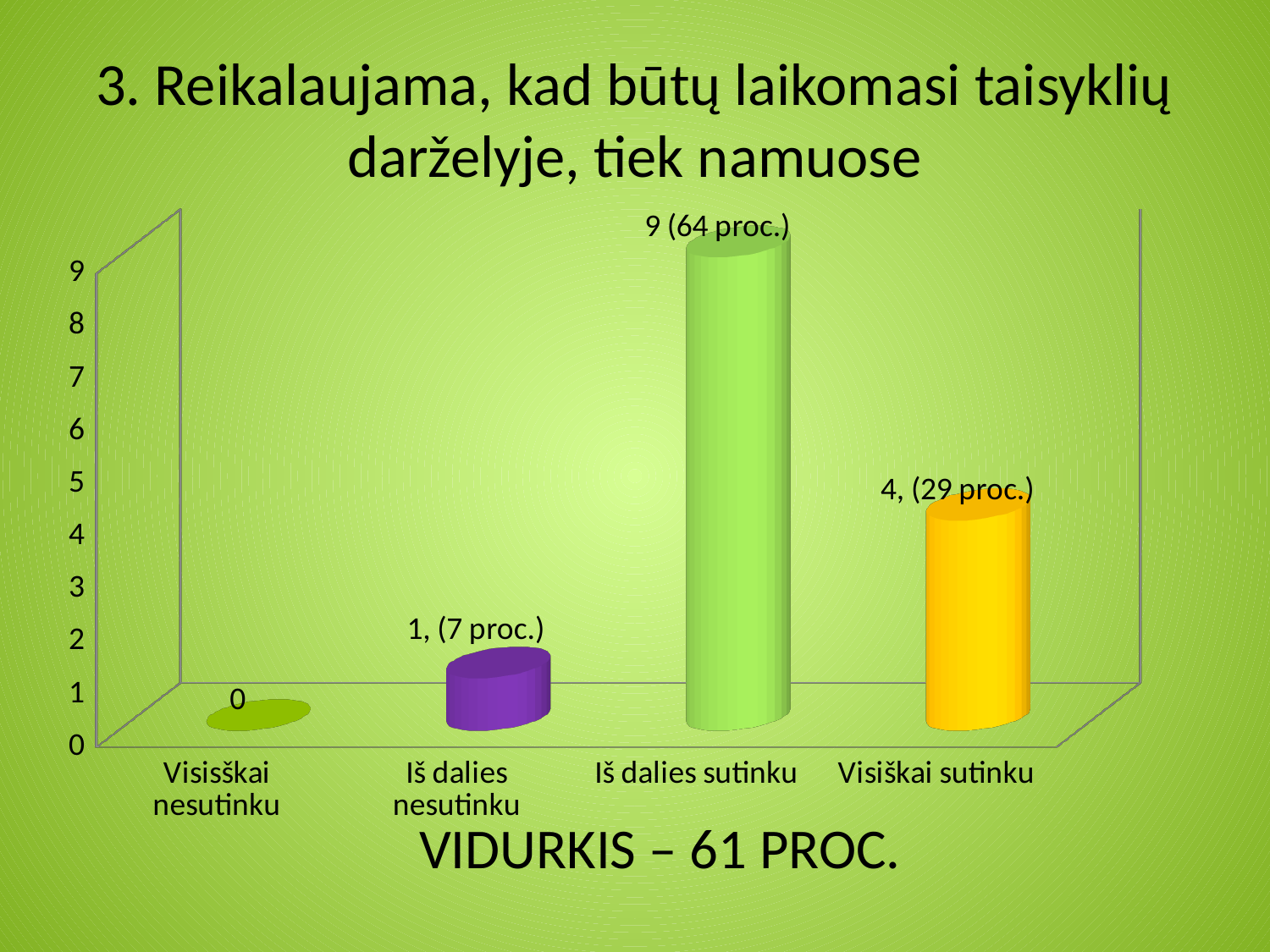
Is the value for "Iš dalies sutinku" greater or less than 5? greater What is the value shown for "Visiškai sutinku"? 4, (29 proc.) What is the difference in count between "Iš dalies sutinku" and "Visiškai sutinku"? 5 What kind of chart is shown on the slide? bar chart What is the value shown for "Iš dalies nesutinku"? 1, (7 proc.) Which is larger, the value for "Visiškai sutinku" or the value for "Iš dalies nesutinku"? Visiškai sutinku What is the value shown for "Iš dalies sutinku"? 9 (64 proc.) What average (VIDURKIS) is stated below the chart? 61 PROC. What is the value shown for "Visisškai nesutinku"? 0 How many categories are shown on the x axis? 4 Which category has the highest value? Iš dalies sutinku Which category has the lowest value? Visisškai nesutinku